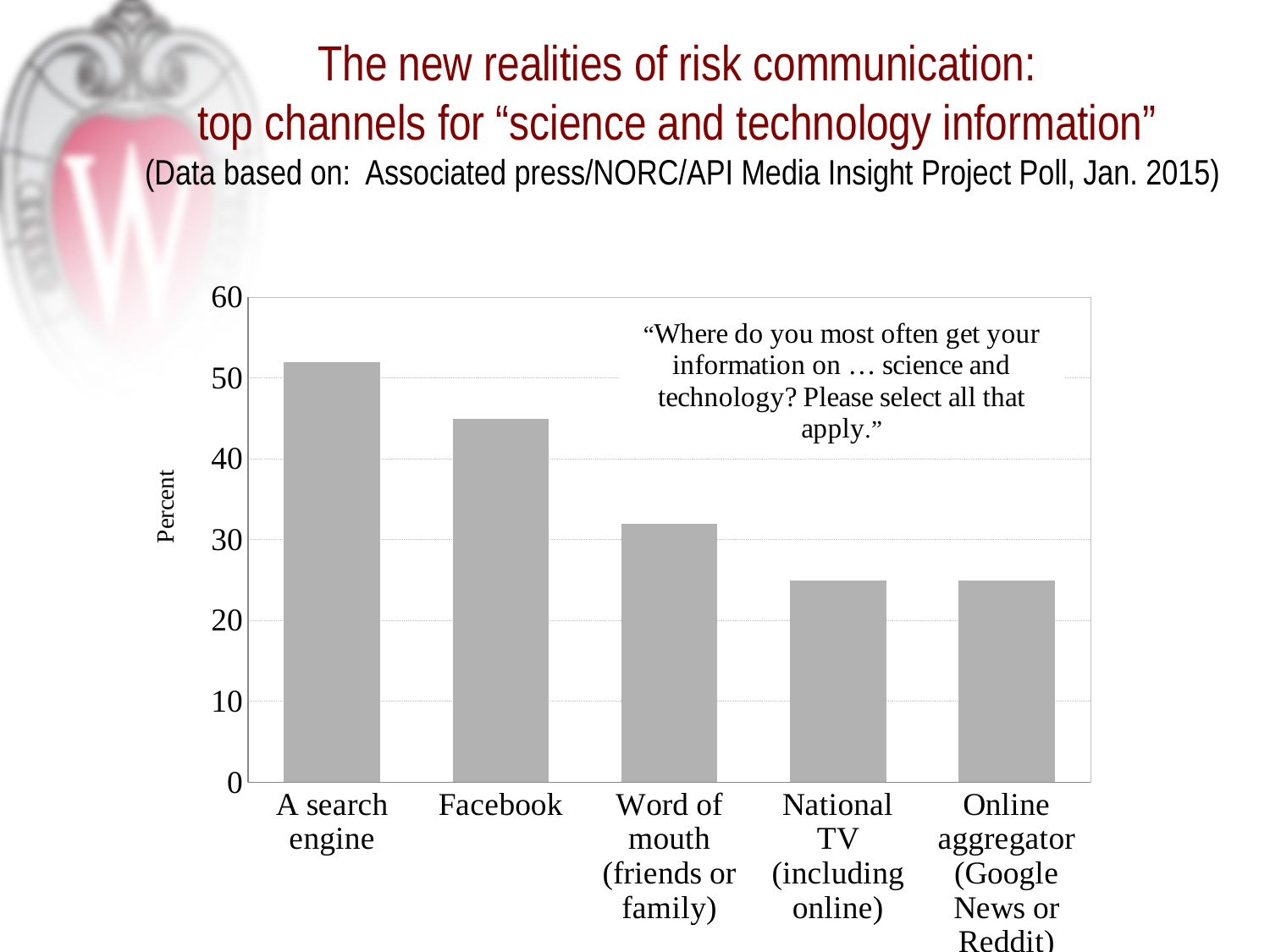
What is the label on the vertical axis of the chart? Percent Is the value for Word of mouth (friends or family) greater or less than 30? greater Is the value for National TV (including online) greater or less than 30? less Which is larger, the value for A search engine or the value for Facebook? A search engine Which channel has the highest percentage? A search engine What kind of chart is shown on the slide? bar chart Is the value for A search engine greater or less than 50? greater How many channels (bars) are shown in the chart? 5 Do the values rise or fall moving from left to right across the chart? fall